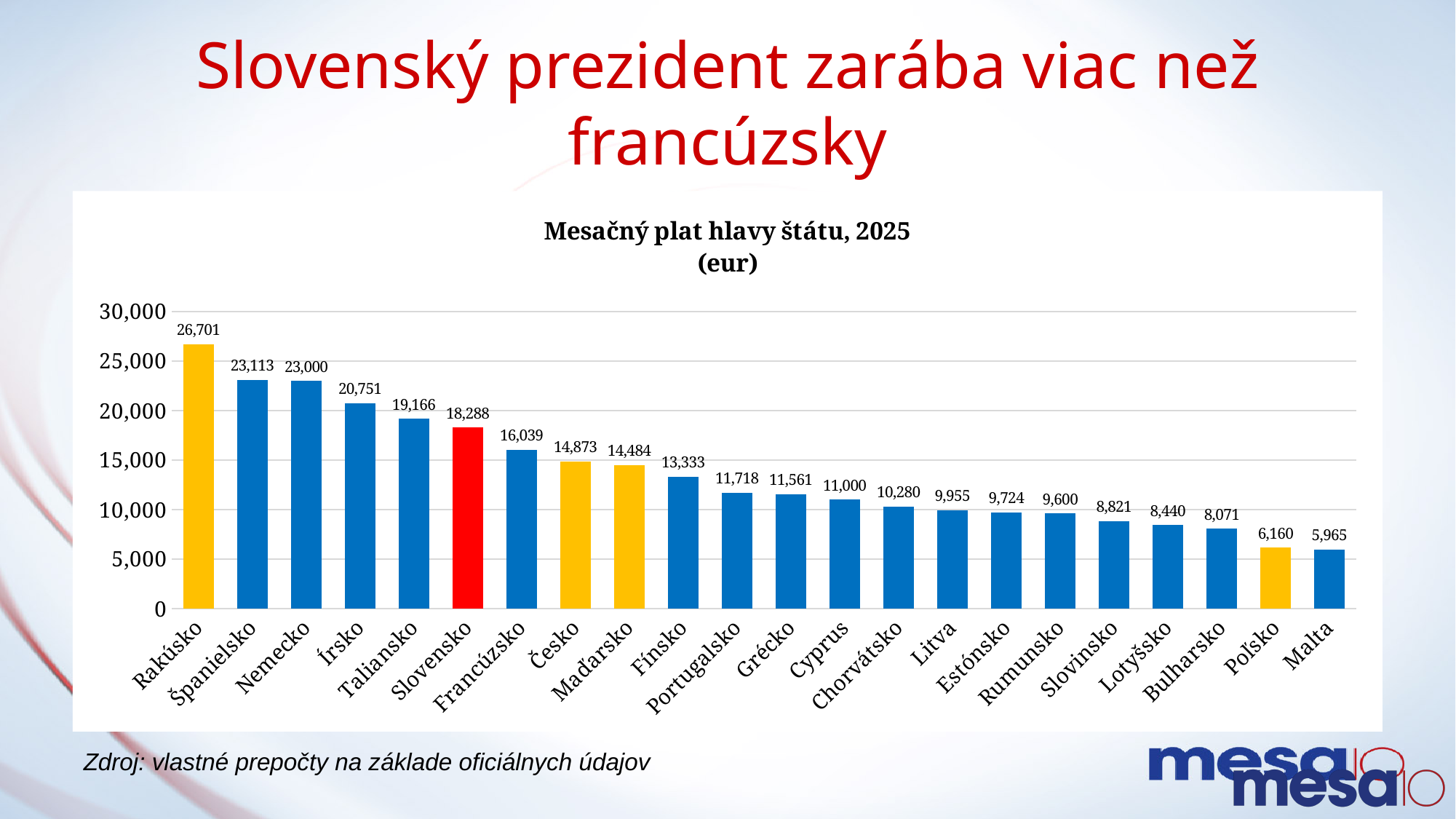
What is the difference between the values for Slovensko and Francúzsko? 2,249 Which country has the lowest value? Malta Is the value for Fínsko greater or less than 15,000? less What is the difference between the values for Rakúsko and Malta? 20,736 What is the value for Slovensko? 18,288 What is the value for Francúzsko? 16,039 How many countries are shown in the chart? 22 Which country has the highest value? Rakúsko What is the value for Poľsko? 6,160 What is the title of the chart? Mesačný plat hlavy štátu, 2025 (eur) Which is larger, the value for Česko or the value for Maďarsko? Česko What kind of chart is shown on the slide? bar chart